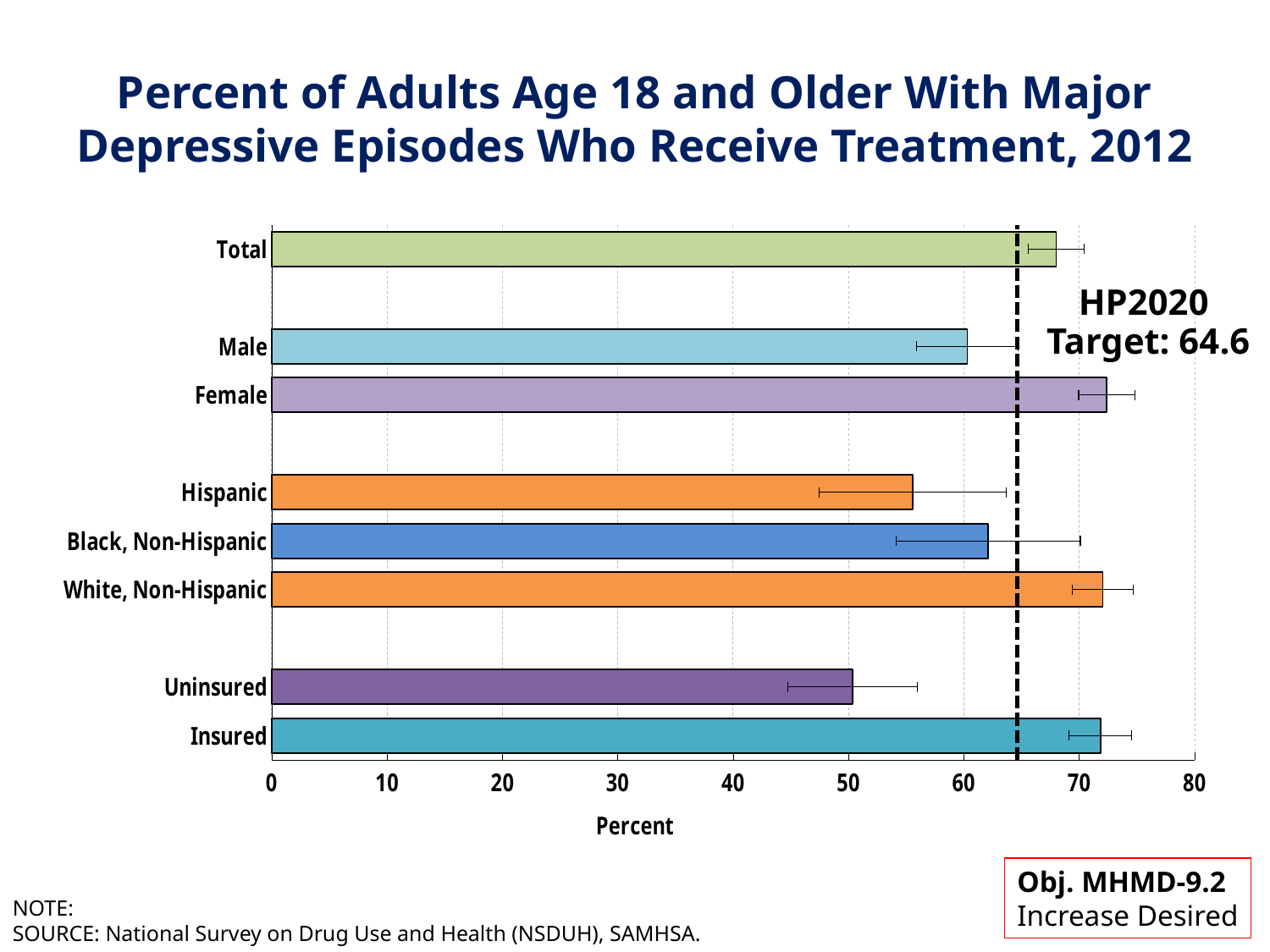
Which category has the lowest percent receiving treatment? Uninsured How many categories (bars) are plotted in the chart? 8 What is the HP2020 target value shown on the chart? 64.6 Is the value for Uninsured greater or less than 60? less Which is larger, the value for Insured or the value for Uninsured? Insured Which is larger, the value for Female or the value for Male? Female Is the value for Hispanic greater or less than 60? less Is the value for Total greater or less than 60? greater What is the label of the horizontal axis? Percent What kind of chart is shown on the slide? bar chart